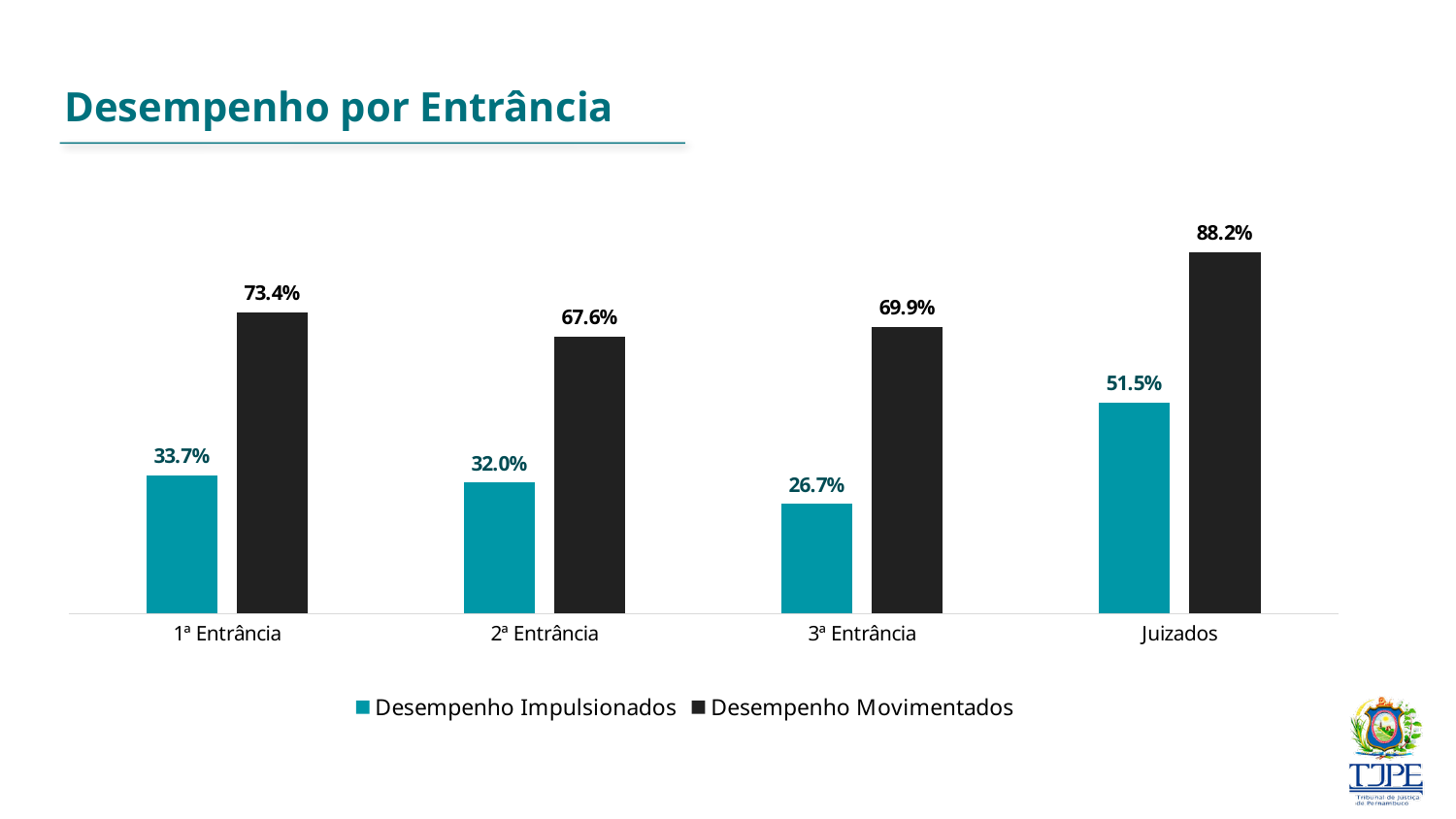
How many categories are shown on the x axis? 4 What is the value of Desempenho Impulsionados for 1ª Entrância? 33.7% What is the value of Desempenho Movimentados for 2ª Entrância? 67.6% Which category has the lowest Desempenho Movimentados value? 2ª Entrância What is the value of Desempenho Movimentados for Juizados? 88.2% What is the difference between Desempenho Movimentados and Desempenho Impulsionados for 3ª Entrância? 43.2% Which category has the highest Desempenho Impulsionados value? Juizados Which is larger: Desempenho Movimentados for 1ª Entrância or for 3ª Entrância? 1ª Entrância What kind of chart is shown on the slide? Bar chart Which category has the lowest Desempenho Impulsionados value? 3ª Entrância What is the title of the chart? Desempenho por Entrância How many series does the legend list? 2